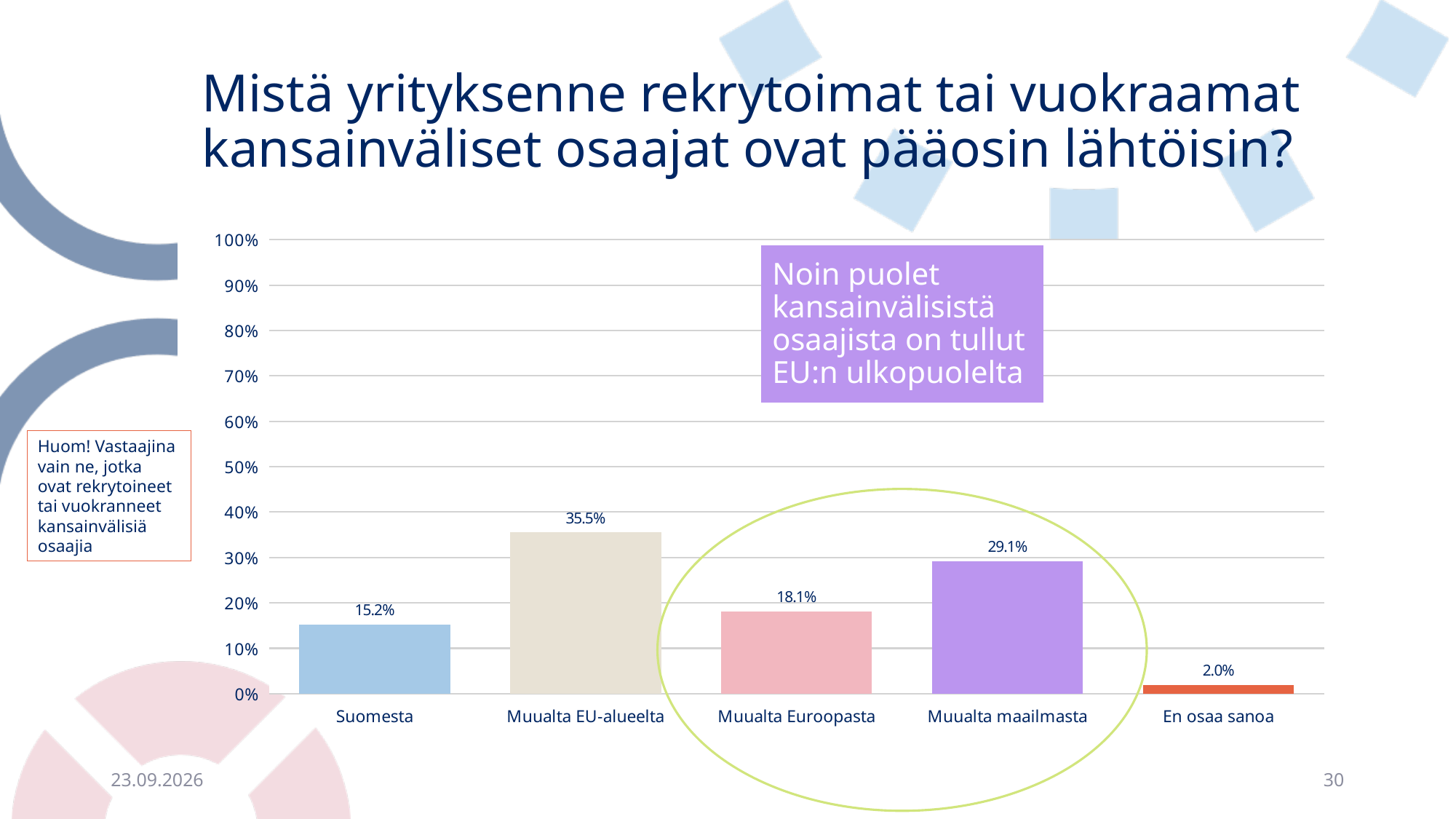
What is the value for Muualta Euroopasta? 18.1% What is the value for Suomesta? 15.2% What is the difference between the values for Muualta EU-alueelta and Muualta maailmasta? 6.4% Which is larger, the value for Suomesta or the value for Muualta Euroopasta? Muualta Euroopasta What is the value for En osaa sanoa? 2.0% What is the combined value of Muualta Euroopasta and Muualta maailmasta? 47.2% What is the value for Muualta EU-alueelta? 35.5% Which category has the highest value? Muualta EU-alueelta How many categories are shown on the x axis? 5 Which category has the lowest value? En osaa sanoa What is the value for Muualta maailmasta? 29.1% What kind of chart is shown on the slide? Bar chart